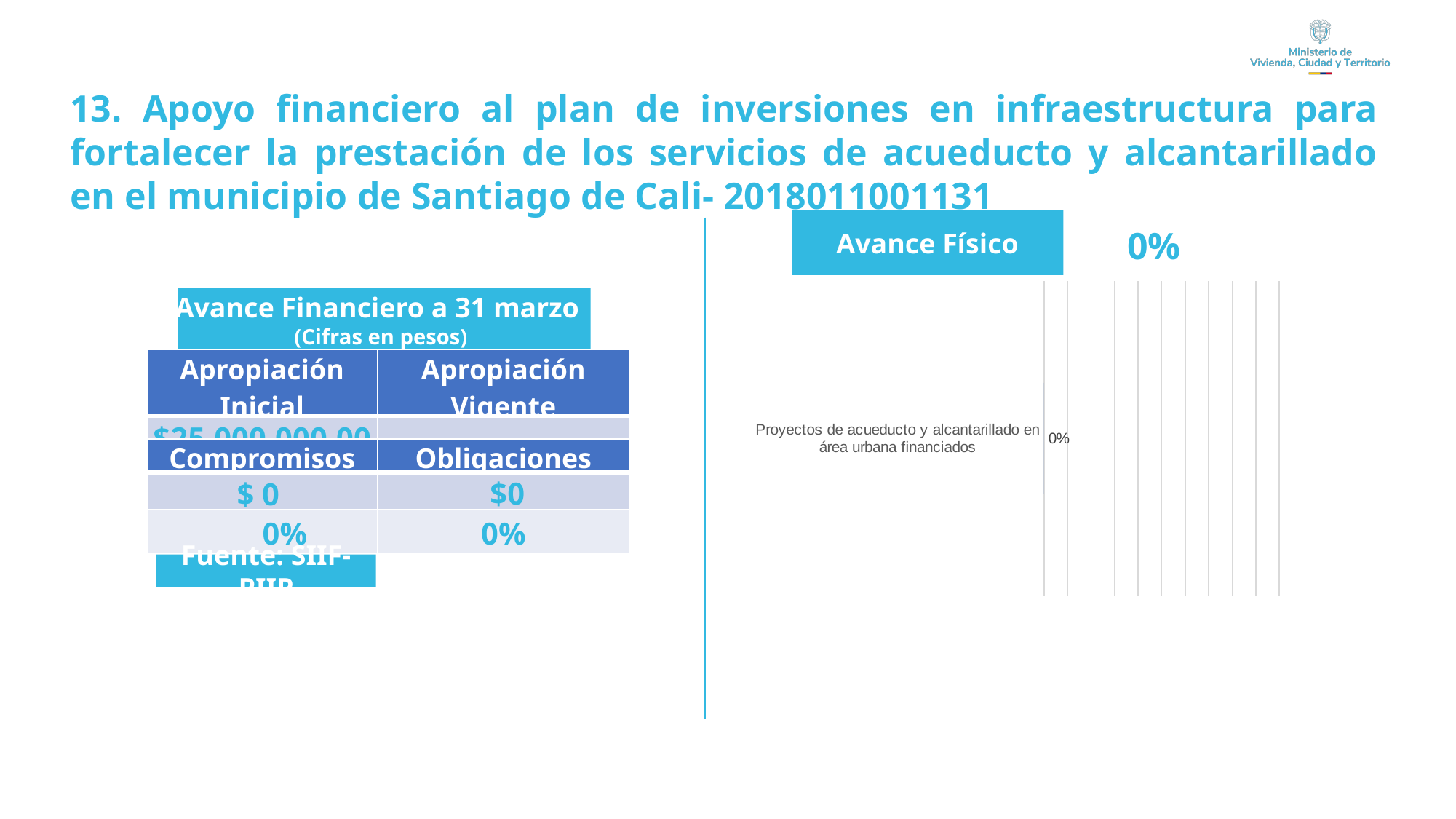
What is the label of the single category plotted in the Avance Físico chart? Proyectos de acueducto y alcantarillado en área urbana financiados How many categories are plotted in the Avance Físico chart? 1 In the Avance Físico chart, what is the value shown for 'Proyectos de acueducto y alcantarillado en área urbana financiados'? 0% What kind of chart is the Avance Físico chart on the right of the slide? Bar chart What is the title shown above the chart on the right of the slide? Avance Físico